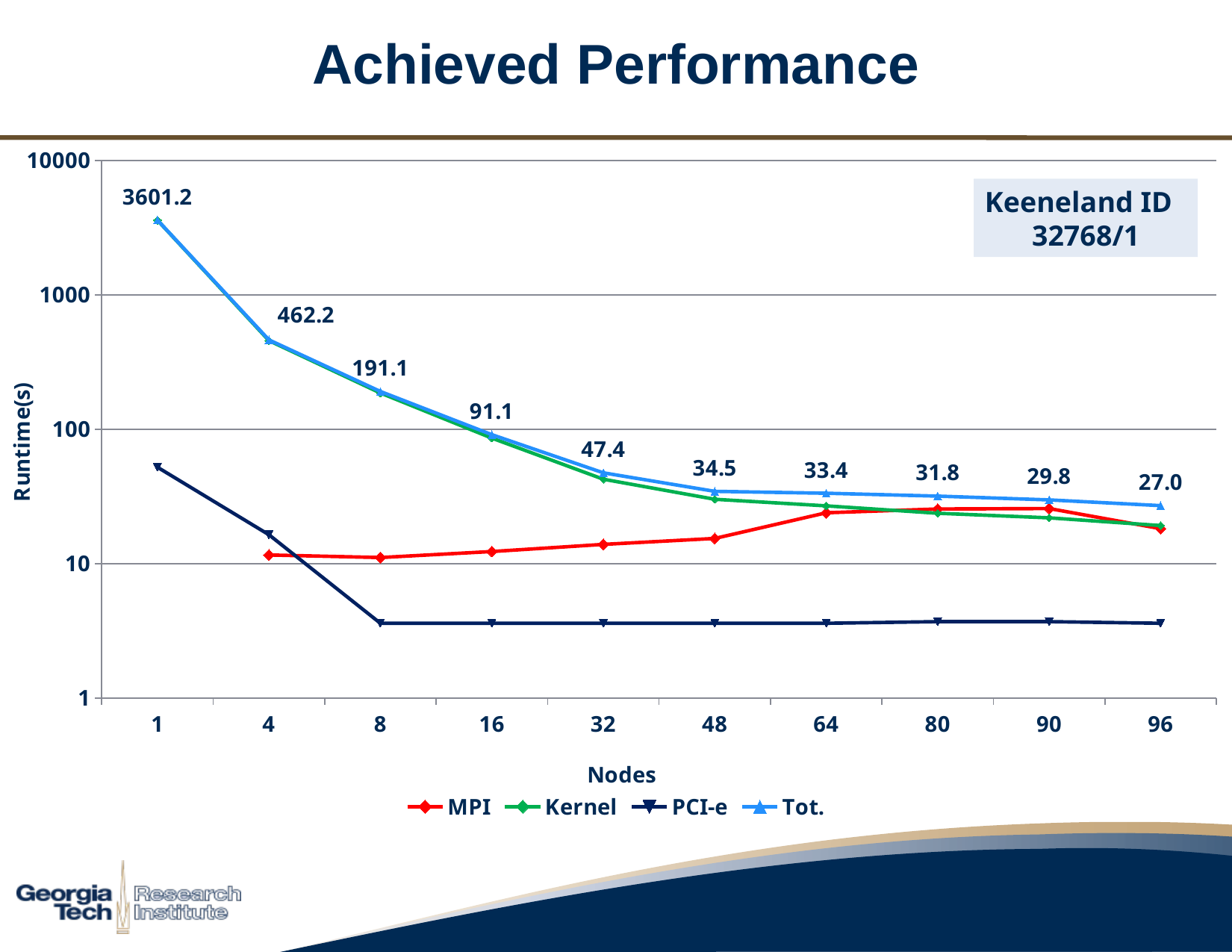
At which node count is the Tot. runtime lowest? 96 What is the Tot. runtime at 32 nodes? 47.4 What is the Tot. runtime at 96 nodes? 27.0 Is the MPI value at 64 nodes greater or less than 10? greater How many series does the legend list? 4 What is the difference between the Tot. runtime at 4 nodes and at 8 nodes? 271.1 Which has the larger Tot. runtime, 48 nodes or 64 nodes? 48 nodes Is the PCI-e value at 8 nodes greater or less than 10? less How many node counts are shown on the x axis? 10 What is the Tot. runtime at 1 node? 3601.2 At which node count is the Tot. runtime highest? 1 Does the Tot. runtime rise or fall as the number of nodes increases? falls